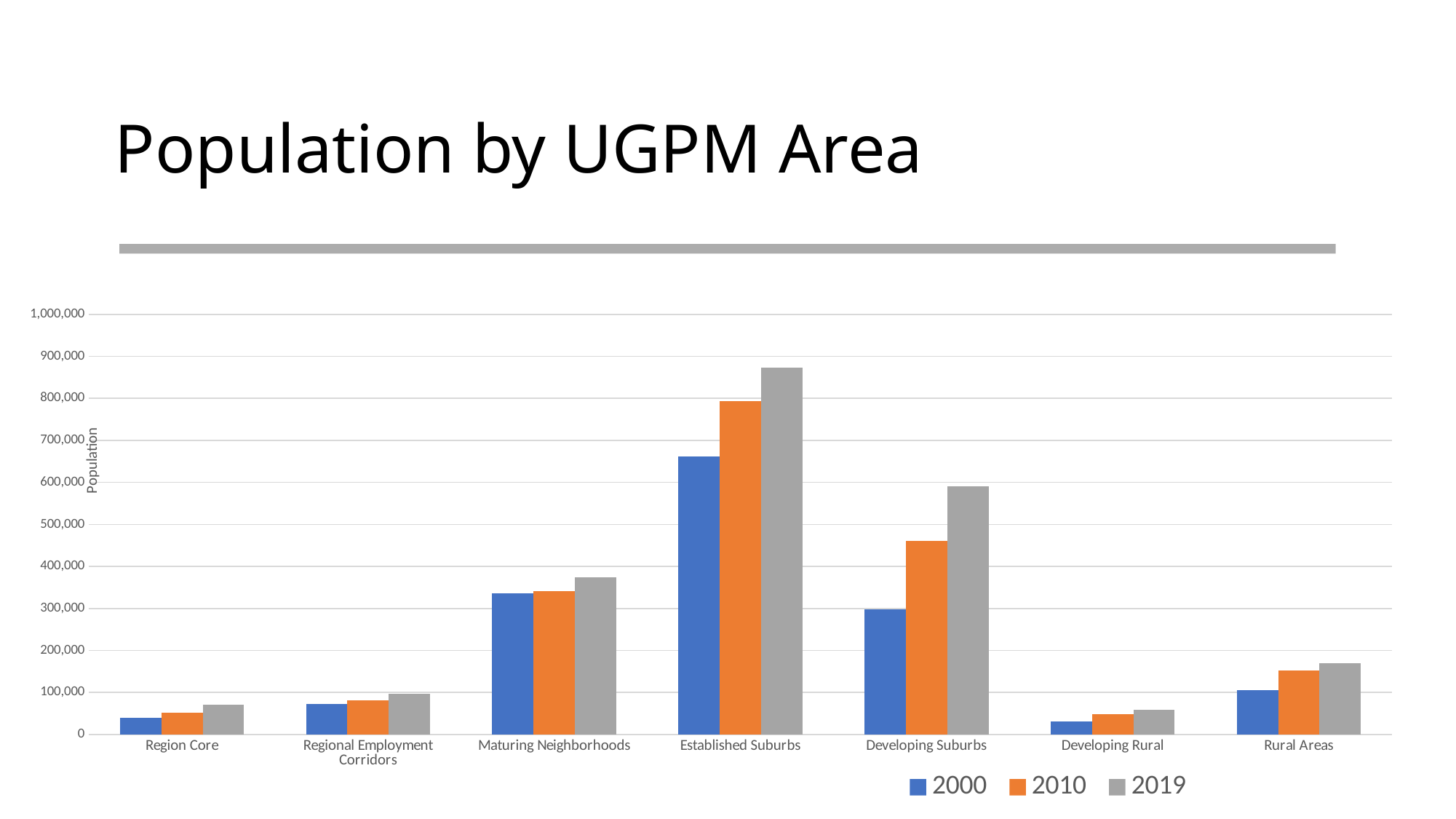
Is the 2019 population for Established Suburbs greater or less than 800,000? greater How many UGPM area categories are shown on the x axis? 7 Does the population of Developing Suburbs rise or fall from 2000 to 2010 to 2019? rise Which area has the highest population in 2019? Established Suburbs What is the title of the y axis? Population What kind of chart is shown on the slide? bar chart How many series does the legend list? 3 What colour represents the 2010 series? orange Which is larger in 2019: the population of Maturing Neighborhoods or Developing Suburbs? Developing Suburbs Which area has the lowest population in 2000? Developing Rural Is the 2019 population for Rural Areas greater or less than 200,000? less Is the 2010 population for Developing Suburbs greater or less than 500,000? less